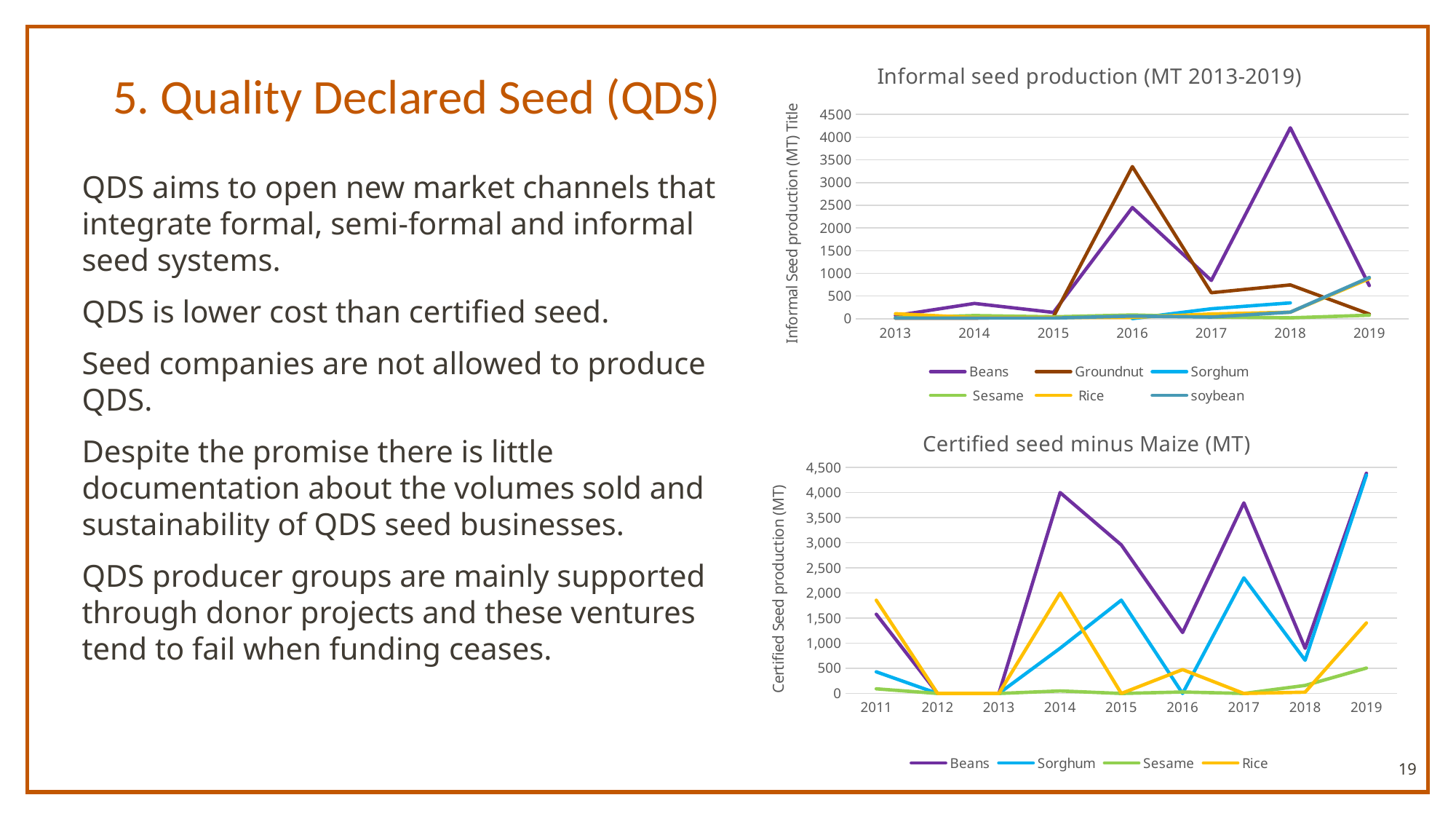
What kind of chart is the 'Informal seed production (MT 2013-2019)' chart? line chart What is the y-axis title of the 'Certified seed minus Maize (MT)' chart? Certified Seed production (MT) In the 'Informal seed production (MT 2013-2019)' chart, is the value for Groundnut in 2016 greater or less than 3000? greater In the 'Informal seed production (MT 2013-2019)' chart, in which year is Beans at its highest? 2018 How many series does the legend of the 'Certified seed minus Maize (MT)' chart list? 4 How many series does the legend of the 'Informal seed production (MT 2013-2019)' chart list? 6 In the 'Certified seed minus Maize (MT)' chart, which is larger in 2017, Beans or Sorghum? Beans How many years are plotted on the x axis of the 'Informal seed production (MT 2013-2019)' chart? 7 In the 'Certified seed minus Maize (MT)' chart, is the value for Beans in 2014 greater or less than 3,500? greater How many years are plotted on the x axis of the 'Certified seed minus Maize (MT)' chart? 9 In the 'Informal seed production (MT 2013-2019)' chart, is the value for Beans in 2018 greater or less than 4000? greater In the 'Informal seed production (MT 2013-2019)' chart, which is larger in 2016, Beans or Groundnut? Groundnut